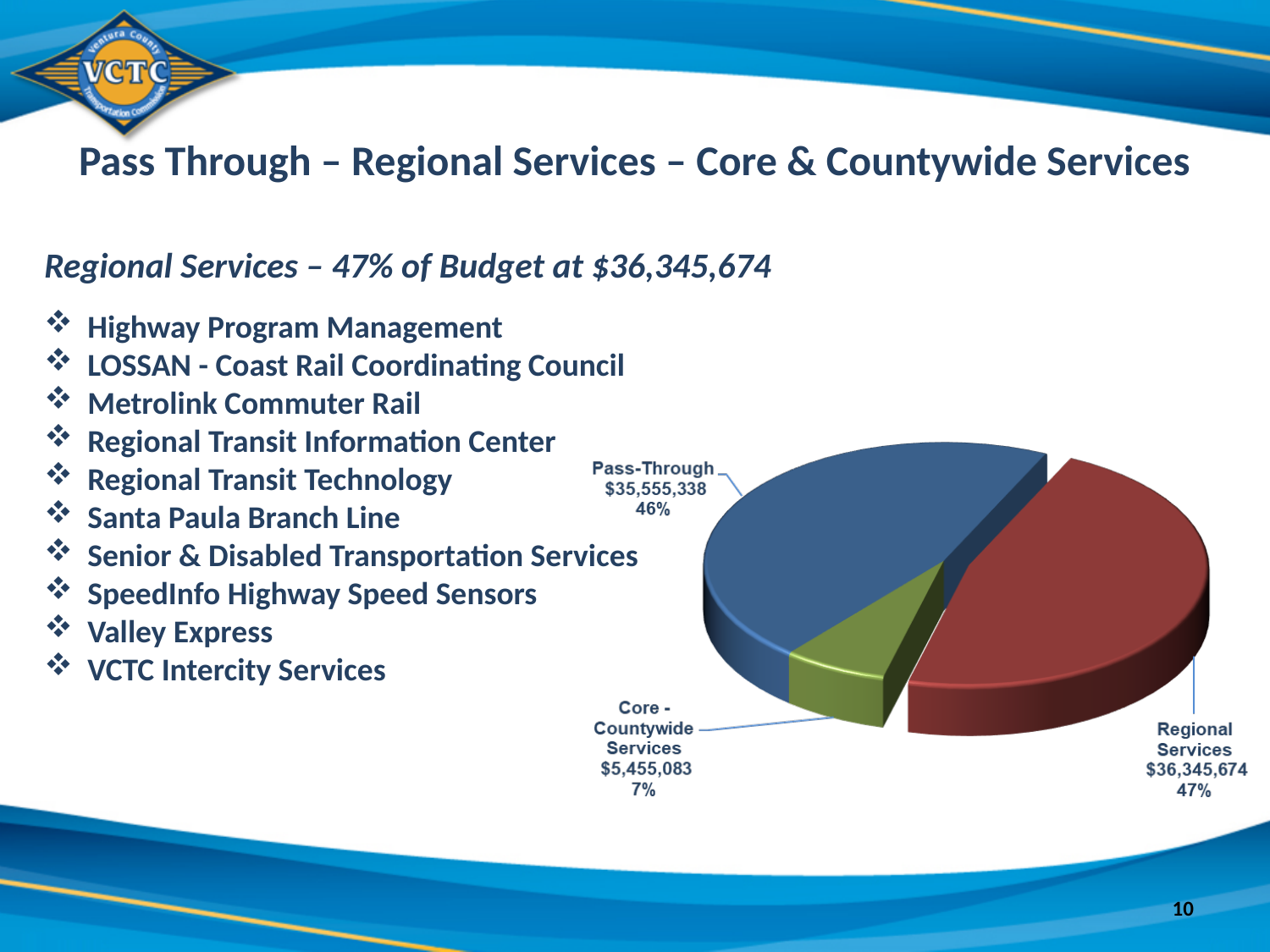
What is the dollar value shown for Core - Countywide Services in the pie chart? $5,455,083 Which slice of the pie chart is the smallest? Core - Countywide Services What percentage share does the Pass-Through slice have? 46% How many slices does the pie chart have? 3 What kind of chart is shown on the slide? Pie chart Which is larger, Pass-Through or Core - Countywide Services? Pass-Through What percentage of the pie does Regional Services represent? 47% What colour is the Regional Services slice in the pie chart? Red What is the combined dollar total of all three slices in the pie chart? $77,356,095 What is the dollar value shown for the Pass-Through slice of the pie chart? $35,555,338 What is the difference in dollars between Regional Services and Pass-Through? $790,336 Which slice of the pie chart is the largest? Regional Services